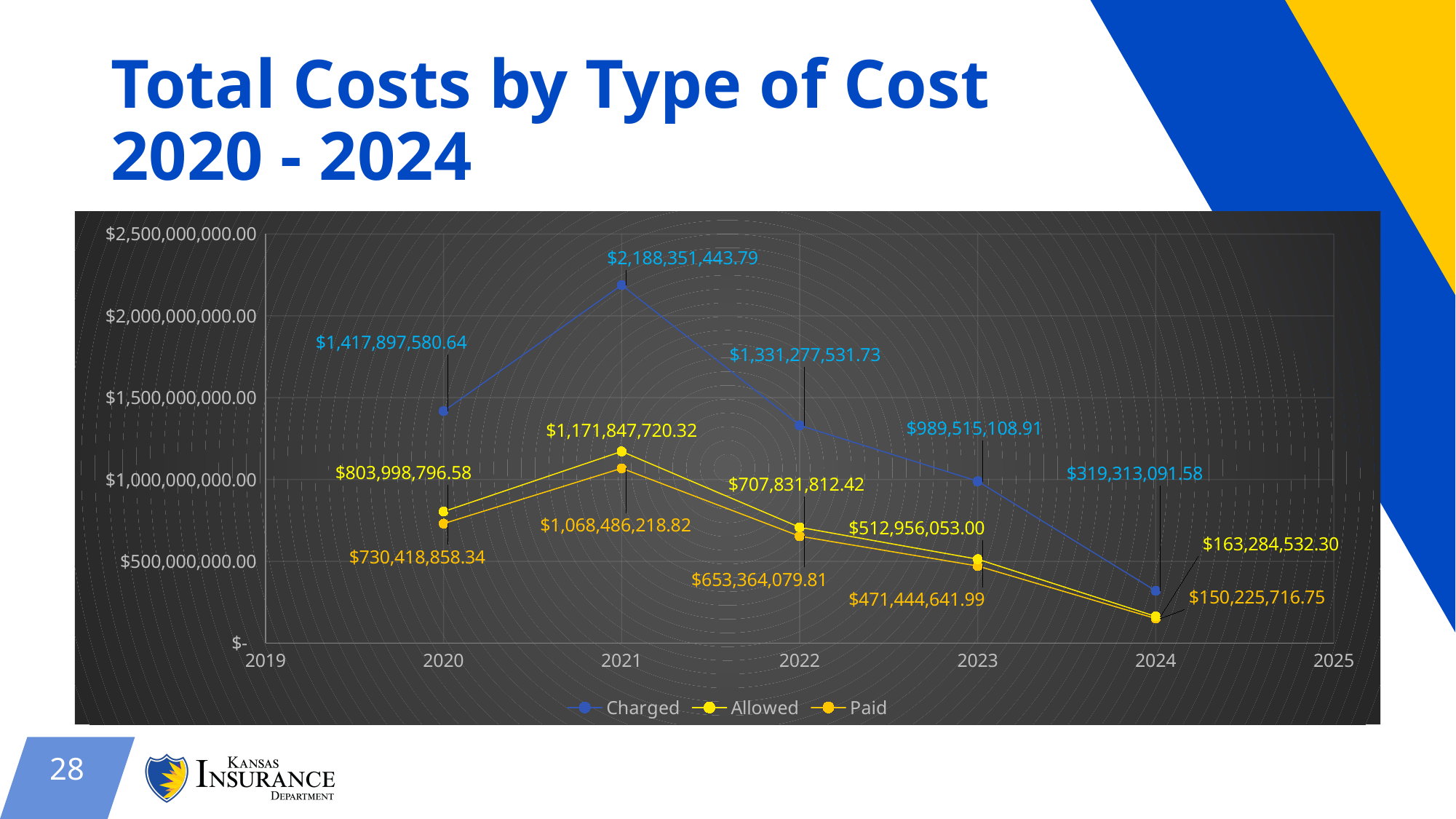
In which year was the Charged amount highest? 2021 From 2021 to 2024, do the Charged values rise or fall? Fall What is the difference between the Charged amount in 2021 and the Charged amount in 2020? $770,453,863.15 What was the Charged amount in 2021? $2,188,351,443.79 What was the Allowed amount in 2024? $163,284,532.30 In which year was the Paid amount lowest? 2024 What was the Paid amount in 2022? $653,364,079.81 How many series does the legend list? 3 Which was larger in 2022, the Charged amount or the Allowed amount? Charged What is the difference between the Allowed and Paid amounts in 2023? $41,511,411.01 How many years have data points plotted for each series? 5 What type of chart is shown on the slide? Line chart